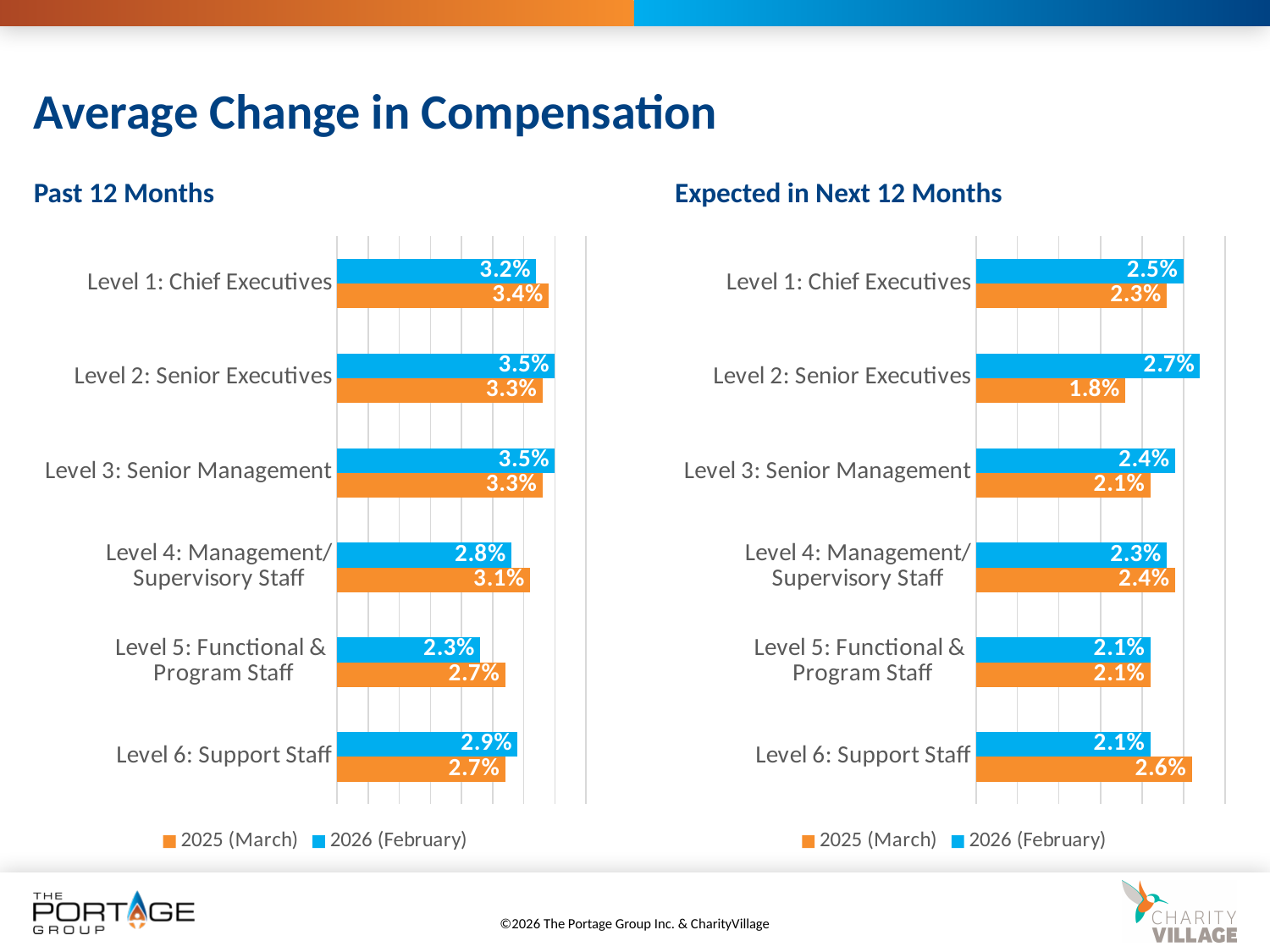
In the Past 12 Months chart, what is the 2025 (March) value for Level 5: Functional & Program Staff? 2.7% What type of chart is the Past 12 Months chart? Bar chart How many series does the legend of the Expected in Next 12 Months chart list? 2 In the Expected in Next 12 Months chart, what is the 2025 (March) value for Level 6: Support Staff? 2.6% In the Past 12 Months chart, which level has the highest 2025 (March) value? Level 1: Chief Executives How many levels are shown in the Past 12 Months chart? 6 In the Expected in Next 12 Months chart, what is the difference between the 2026 (February) and 2025 (March) values for Level 2: Senior Executives? 0.9% In the Past 12 Months chart, what is the 2026 (February) value for Level 1: Chief Executives? 3.2% In the Expected in Next 12 Months chart, which level has the highest 2026 (February) value? Level 2: Senior Executives In the Expected in Next 12 Months chart, what is the 2025 (March) value for Level 2: Senior Executives? 1.8% In the Past 12 Months chart, which level has the lowest 2026 (February) value? Level 5: Functional & Program Staff In the Past 12 Months chart, which is larger for Level 4: Management/Supervisory Staff, the 2025 (March) value or the 2026 (February) value? 2025 (March)